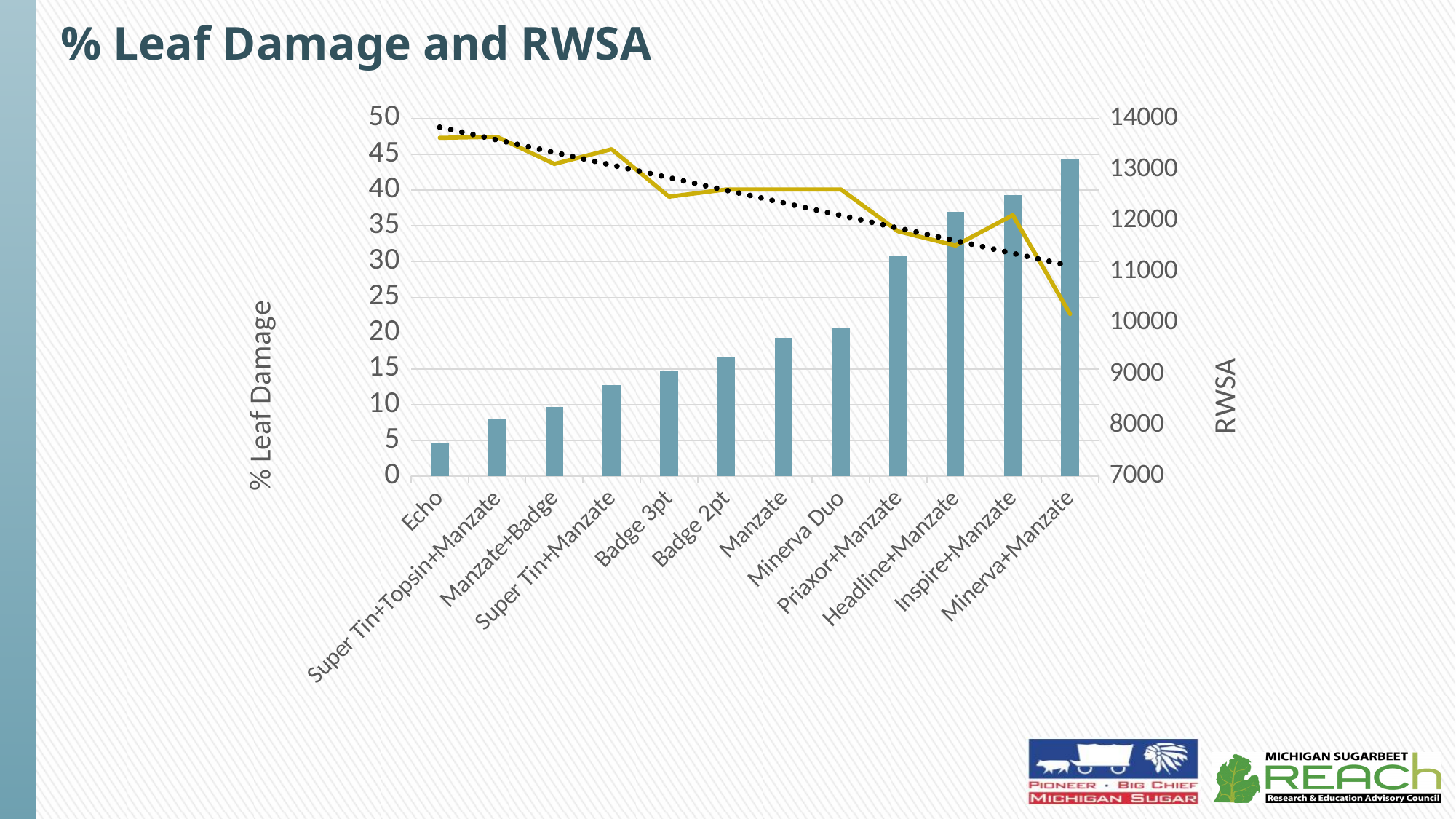
What is the label of the right-hand vertical axis? RWSA Which treatment has the lowest RWSA value on the line? Minerva+Manzate Which has the higher % Leaf Damage, Badge 3pt or Headline+Manzate? Headline+Manzate Is the % Leaf Damage value for Echo greater or less than 10? less Which treatment has the lowest % Leaf Damage bar? Echo Which treatment has the highest % Leaf Damage bar? Minerva+Manzate Is the % Leaf Damage value for Minerva+Manzate greater or less than 40? greater Does the RWSA line generally rise or fall from left to right along the x axis? Fall Is the RWSA value for Minerva+Manzate greater or less than 11000? less What kind of chart is shown on the slide? A bar chart combined with a line chart How many treatment categories are shown on the x axis? 12 Do the % Leaf Damage bars rise or fall from left to right along the x axis? Rise